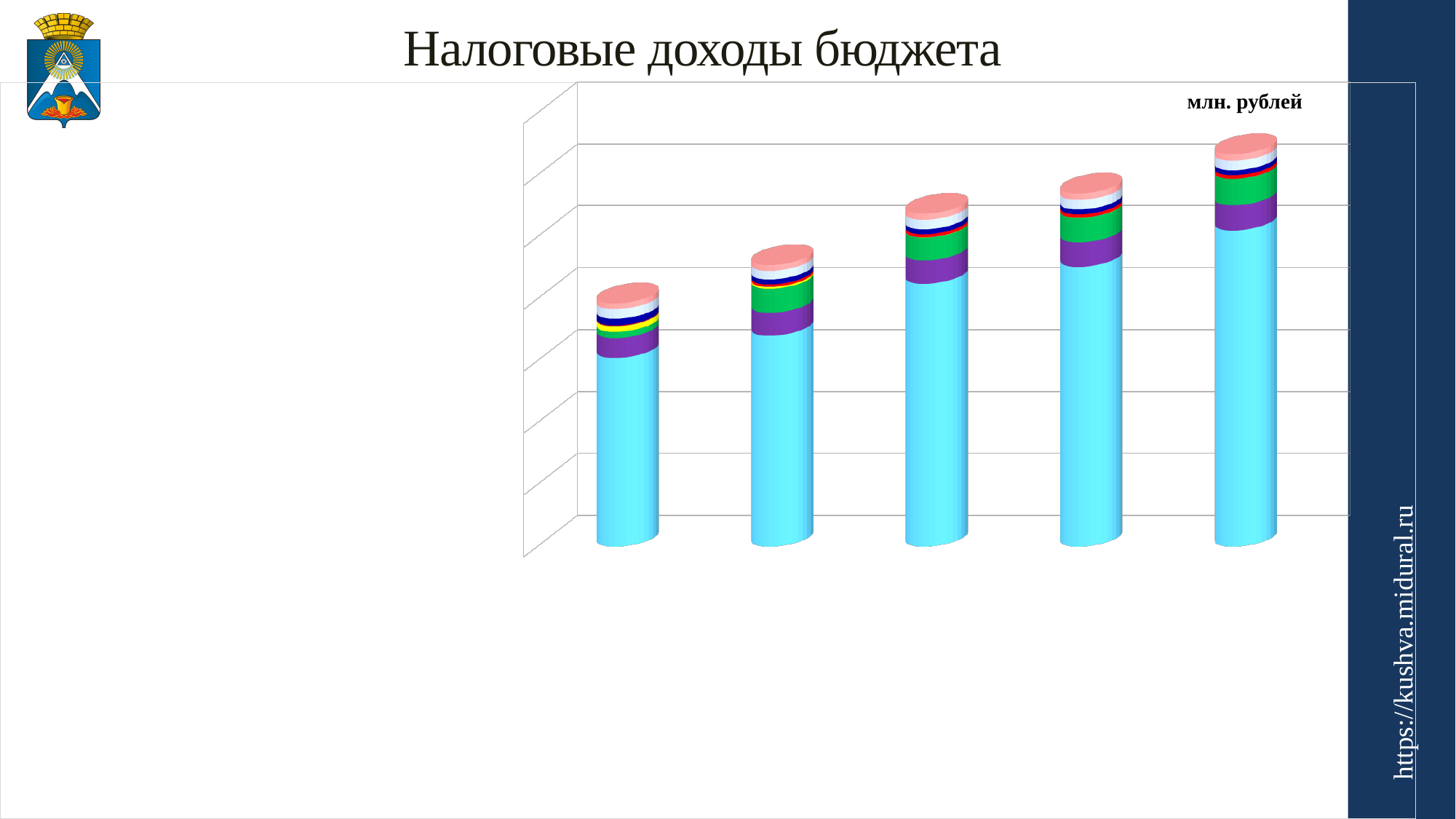
How many bars are plotted in the chart? 5 Do the bar heights rise or fall from left to right across the chart? rise Which bar is the tallest in the chart: the leftmost or the rightmost? the rightmost Which bar is the shortest in the chart: the leftmost or the rightmost? the leftmost What unit is indicated in the top right corner of the chart? млн. рублей Is the second bar from the left taller or shorter than the fourth bar from the left? shorter What is the title of the chart on the slide? Налоговые доходы бюджета What kind of chart is shown on the slide? bar chart